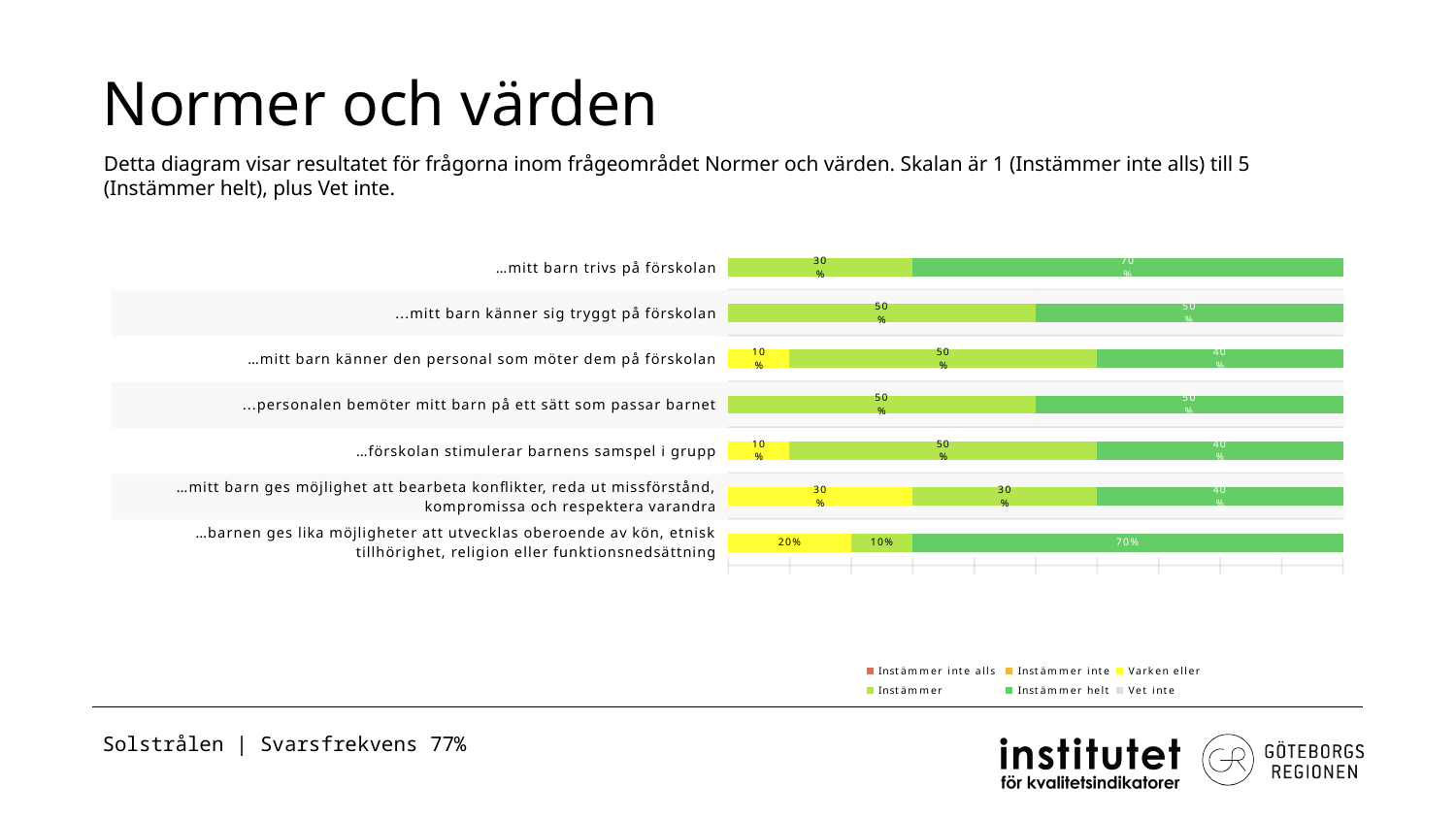
What is the 'Instämmer helt' value for '…mitt barn känner sig tryggt på förskolan'? 50% How many statements (categories) are plotted in the chart? 7 What is the 'Varken eller' value for '…mitt barn ges möjlighet att bearbeta konflikter, reda ut missförstånd, kompromissa och respektera varandra'? 30% What kind of chart is shown on the slide? Stacked bar chart What is the 'Instämmer' value for '…mitt barn trivs på förskolan'? 30% Which is larger for '…förskolan stimulerar barnens samspel i grupp': the 'Instämmer' value or the 'Instämmer helt' value? Instämmer What is the 'Instämmer helt' value for '…mitt barn trivs på förskolan'? 70% What is the 'Instämmer helt' value for '…barnen ges lika möjligheter att utvecklas oberoende av kön, etnisk tillhörighet, religion eller funktionsnedsättning'? 70% What is the title of the slide containing the chart? Normer och värden What is the 'Varken eller' value for '…mitt barn känner den personal som möter dem på förskolan'? 10% How many series does the legend list? 6 What is the difference between the 'Instämmer helt' value and the 'Instämmer' value for '…mitt barn trivs på förskolan'? 40%